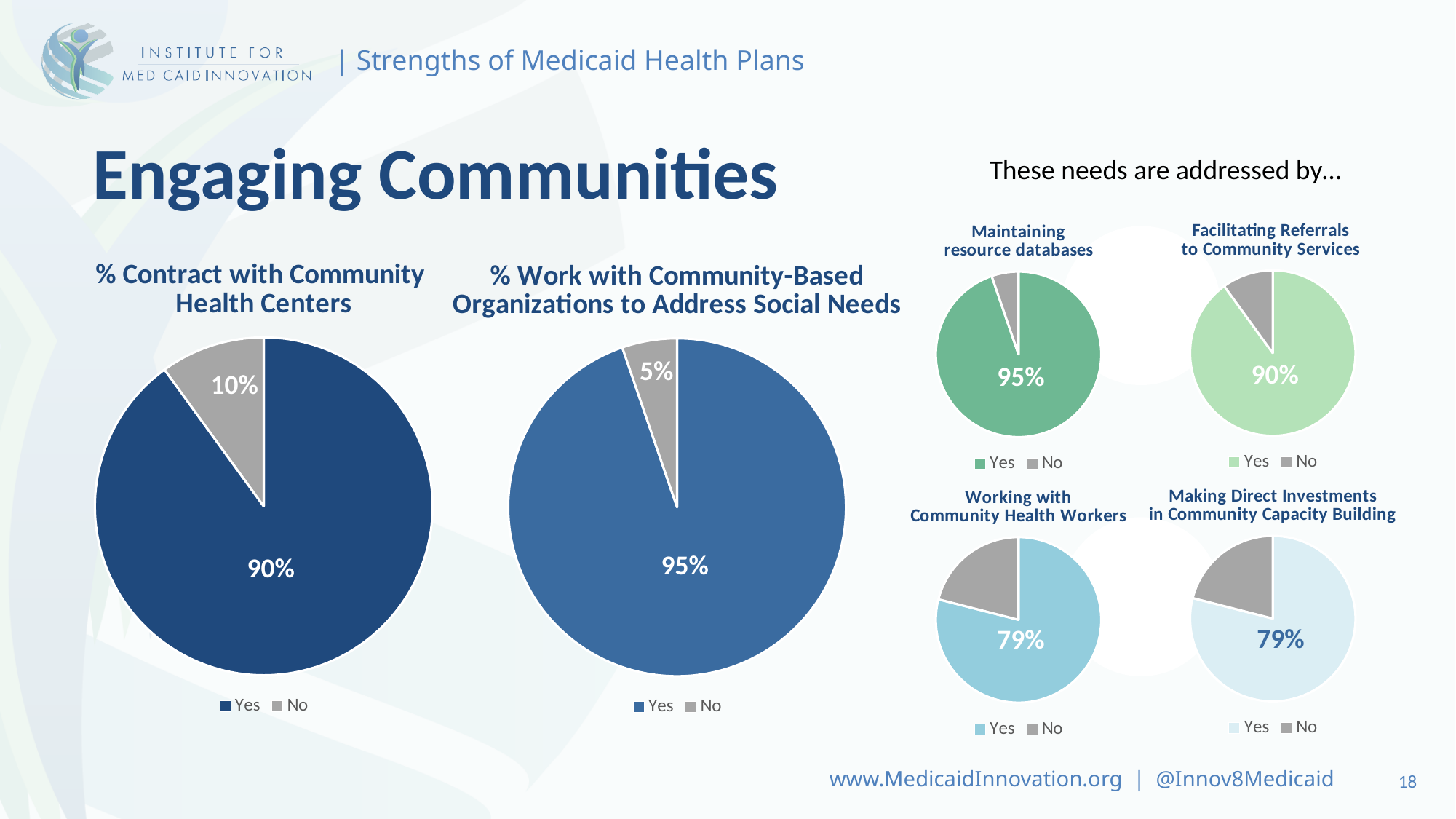
In the '% Contract with Community Health Centers' chart, what percentage answered Yes? 90% How many categories does the legend of the '% Work with Community-Based Organizations to Address Social Needs' chart list? 2 In the '% Work with Community-Based Organizations to Address Social Needs' chart, what percentage answered Yes? 95% Which has a larger Yes share: the 'Maintaining resource databases' chart or the 'Facilitating Referrals to Community Services' chart? Maintaining resource databases In the 'Facilitating Referrals to Community Services' chart, what percentage answered Yes? 90% In the '% Work with Community-Based Organizations to Address Social Needs' chart, what percentage answered No? 5% In the 'Maintaining resource databases' chart, what percentage answered Yes? 95% In the '% Contract with Community Health Centers' chart, what percentage answered No? 10% What type of chart is the '% Contract with Community Health Centers' chart? Pie chart In the '% Contract with Community Health Centers' chart, what is the difference between the Yes and No percentages? 80% In the 'Working with Community Health Workers' chart, what percentage answered Yes? 79% In the 'Making Direct Investments in Community Capacity Building' chart, what percentage answered Yes? 79%